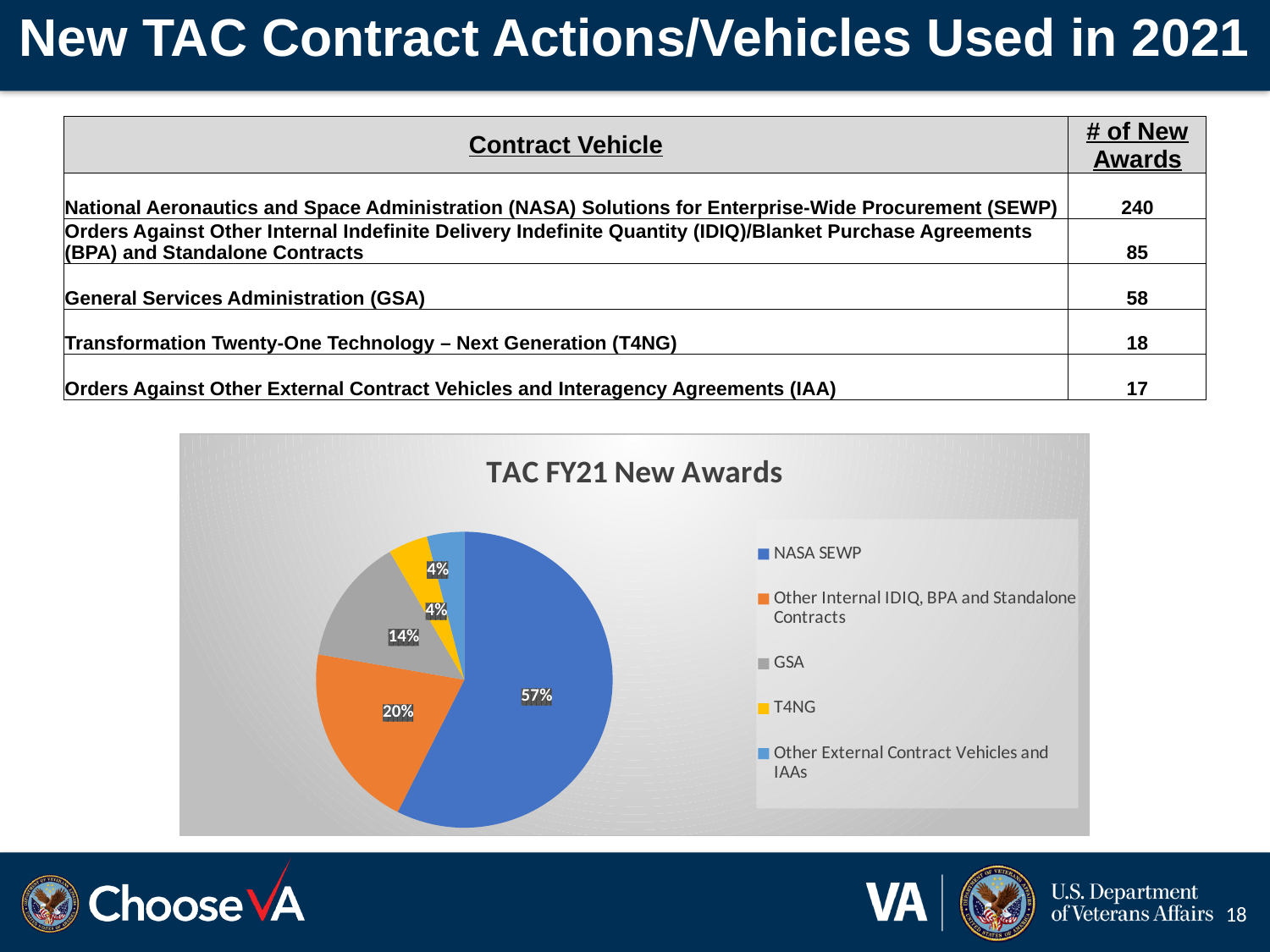
Which category has the largest slice of the pie? NASA SEWP Which is larger, the GSA slice or the Other Internal IDIQ, BPA and Standalone Contracts slice? Other Internal IDIQ, BPA and Standalone Contracts What colour is the NASA SEWP slice in the pie chart? blue What is the difference in percentage points between the NASA SEWP slice and the GSA slice? 43 What type of chart is shown on the slide? pie chart What share of the pie does NASA SEWP represent? 57% What is the title of the chart? TAC FY21 New Awards What share of the pie does GSA represent? 14% What share of the pie does Other Internal IDIQ, BPA and Standalone Contracts represent? 20% How many slices does the pie chart have? 5 How many entries does the chart's legend list? 5